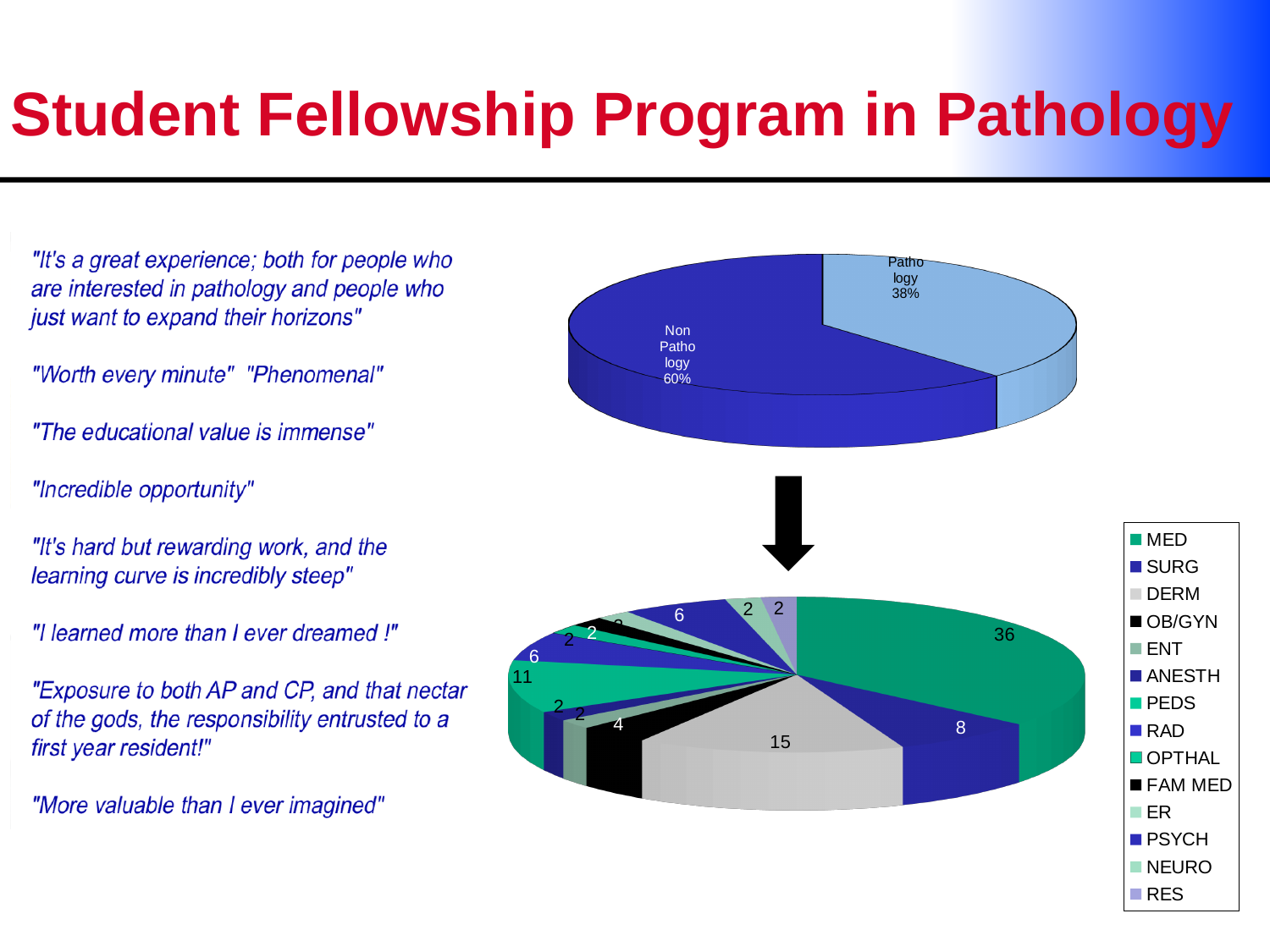
On the bottom pie chart, what is the value for SURG? 8 On the top pie chart, which slice is larger, Pathology or Non Pathology? Non Pathology On the bottom pie chart, which is larger, DERM or SURG? DERM How many slices does the top pie chart have? 2 What kind of chart is the top chart on the slide? Pie chart On the bottom pie chart, which category has the largest slice? MED On the top pie chart, what percentage is shown for Non Pathology? 60% On the bottom pie chart, what is the value for DERM? 15 How many categories does the legend of the bottom pie chart list? 14 On the bottom pie chart, what is the value for MED? 36 On the bottom pie chart, what is the difference between the values for MED and DERM? 21 On the top pie chart, what percentage is shown for Pathology? 38%